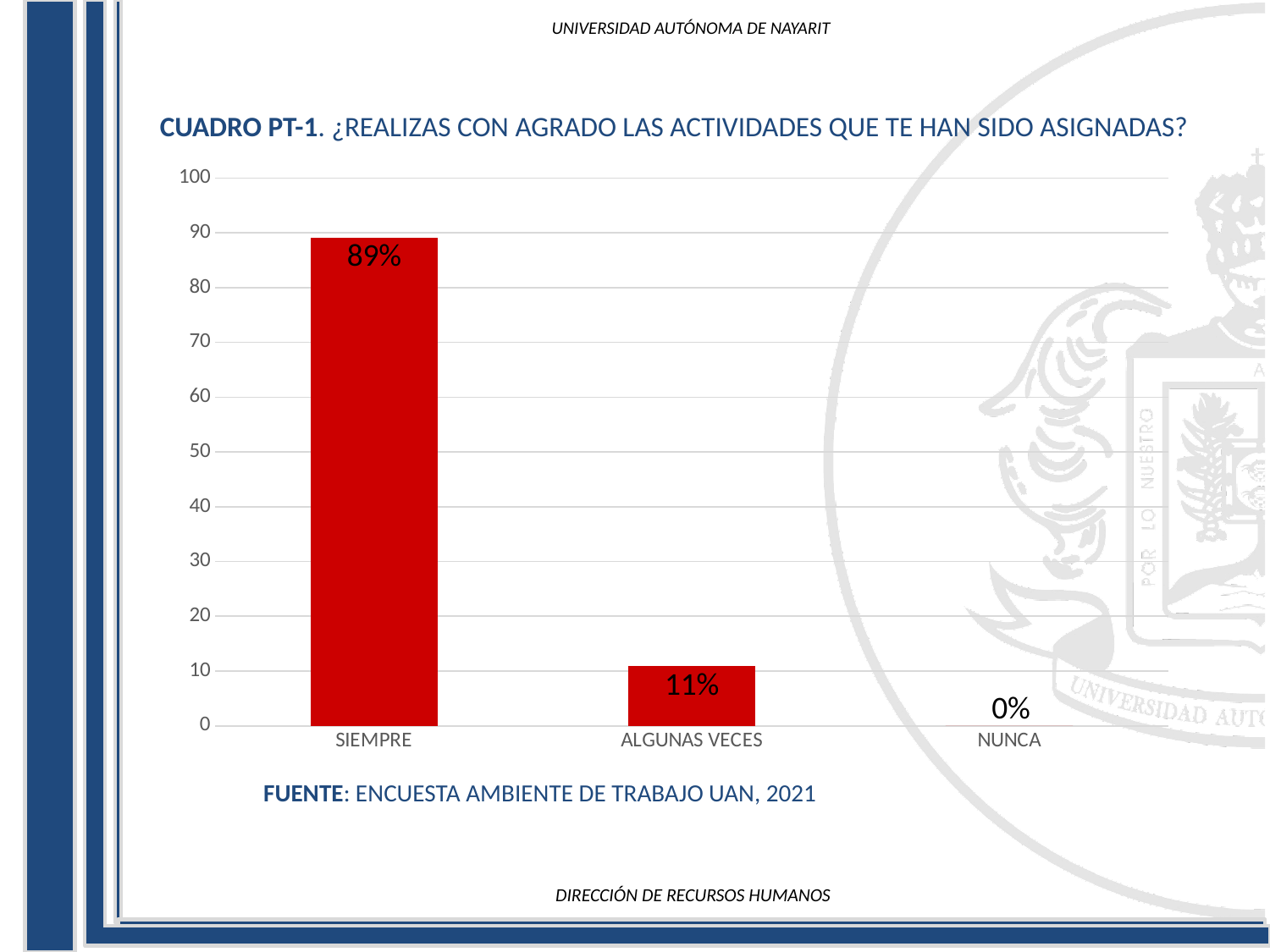
Is the value for SIEMPRE greater or less than 80? greater Which category has the lowest value? NUNCA What kind of chart is shown on the slide? bar chart What is the value for NUNCA? 0% What is the difference between the values for SIEMPRE and ALGUNAS VECES? 78% Is the value for ALGUNAS VECES greater or less than 20? less What source is cited below the chart? ENCUESTA AMBIENTE DE TRABAJO UAN, 2021 What is the value for ALGUNAS VECES? 11% Which category has the highest value? SIEMPRE How many categories are shown on the x axis? 3 Which is larger, the value for ALGUNAS VECES or the value for NUNCA? ALGUNAS VECES What is the value for SIEMPRE? 89%